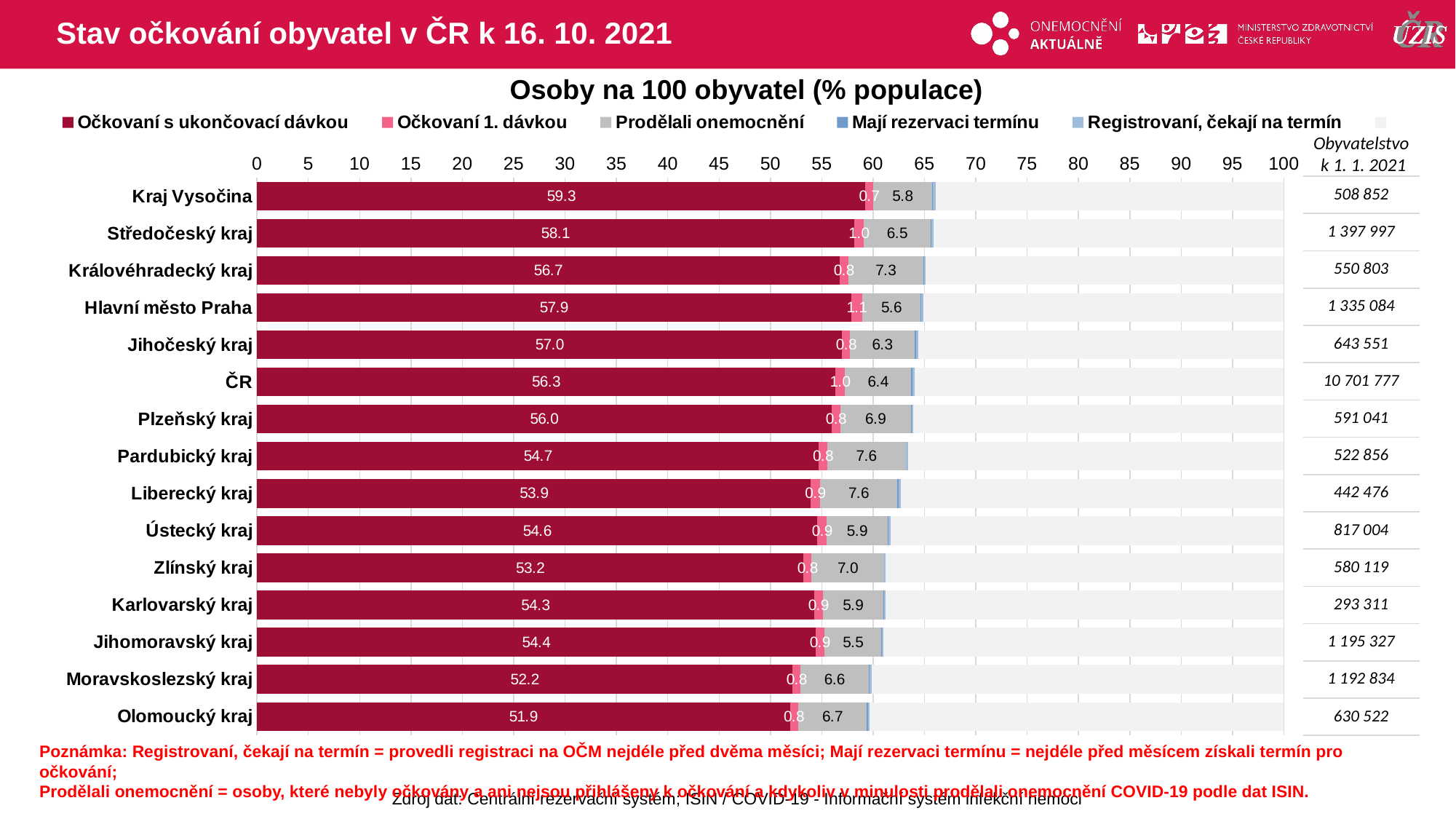
What kind of chart is shown on the slide? bar chart What is the value of Očkovaní s ukončovací dávkou for Kraj Vysočina? 59.3 What is the value of Očkovaní s ukončovací dávkou for ČR? 56.3 How many regions (categories) are plotted in the chart? 15 Which has a larger value of Prodělali onemocnění, Královéhradecký kraj or Jihočeský kraj? Královéhradecký kraj What is the title of the chart? Osoby na 100 obyvatel (% populace) Do the values of Očkovaní s ukončovací dávkou rise or fall going down the list of regions from top to bottom? fall What is the value of Očkovaní 1. dávkou for Hlavní město Praha? 1.1 Which region has the lowest value of Očkovaní s ukončovací dávkou? Olomoucký kraj What is the value of Prodělali onemocnění for Pardubický kraj? 7.6 What is the difference in Očkovaní s ukončovací dávkou between Kraj Vysočina and Olomoucký kraj? 7.4 Which region has the highest value of Očkovaní s ukončovací dávkou? Kraj Vysočina